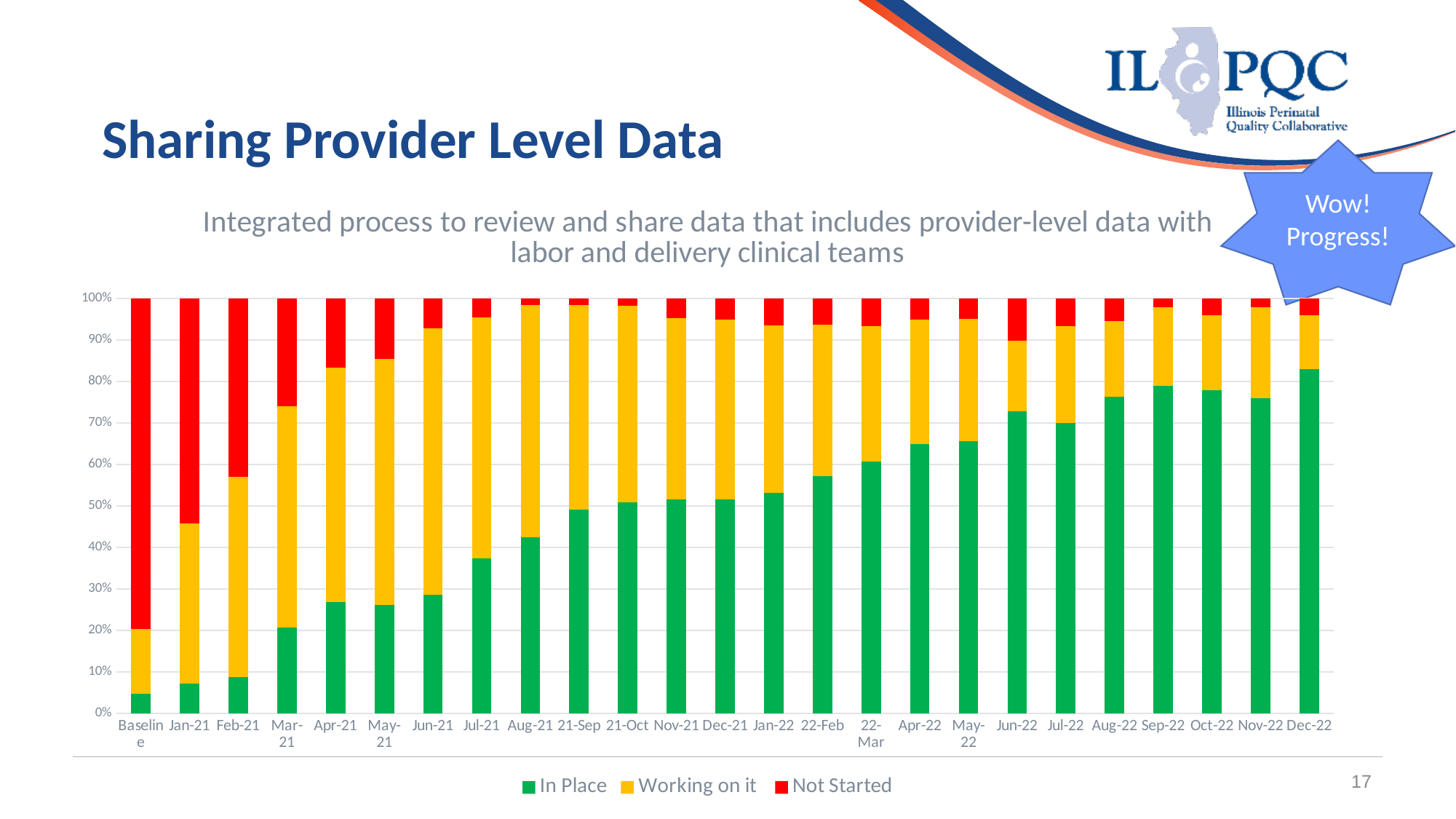
Does the In Place share generally rise or fall from Baseline to Dec-22? Rise Is the In Place value for Aug-22 greater or less than 70%? greater Which colour represents the Working on it series in the chart? Yellow How many series does the chart legend list? 3 How many time-period categories are plotted along the x axis of the chart? 25 Is the In Place value for Baseline greater or less than 10%? less Which category has the largest Not Started share? Baseline What kind of chart is shown on the slide? Stacked bar chart Which category has the highest share for the In Place series? Dec-22 Which has the larger Not Started share, Jan-21 or Feb-21? Jan-21 Is the Not Started value for Baseline greater or less than 70%? greater